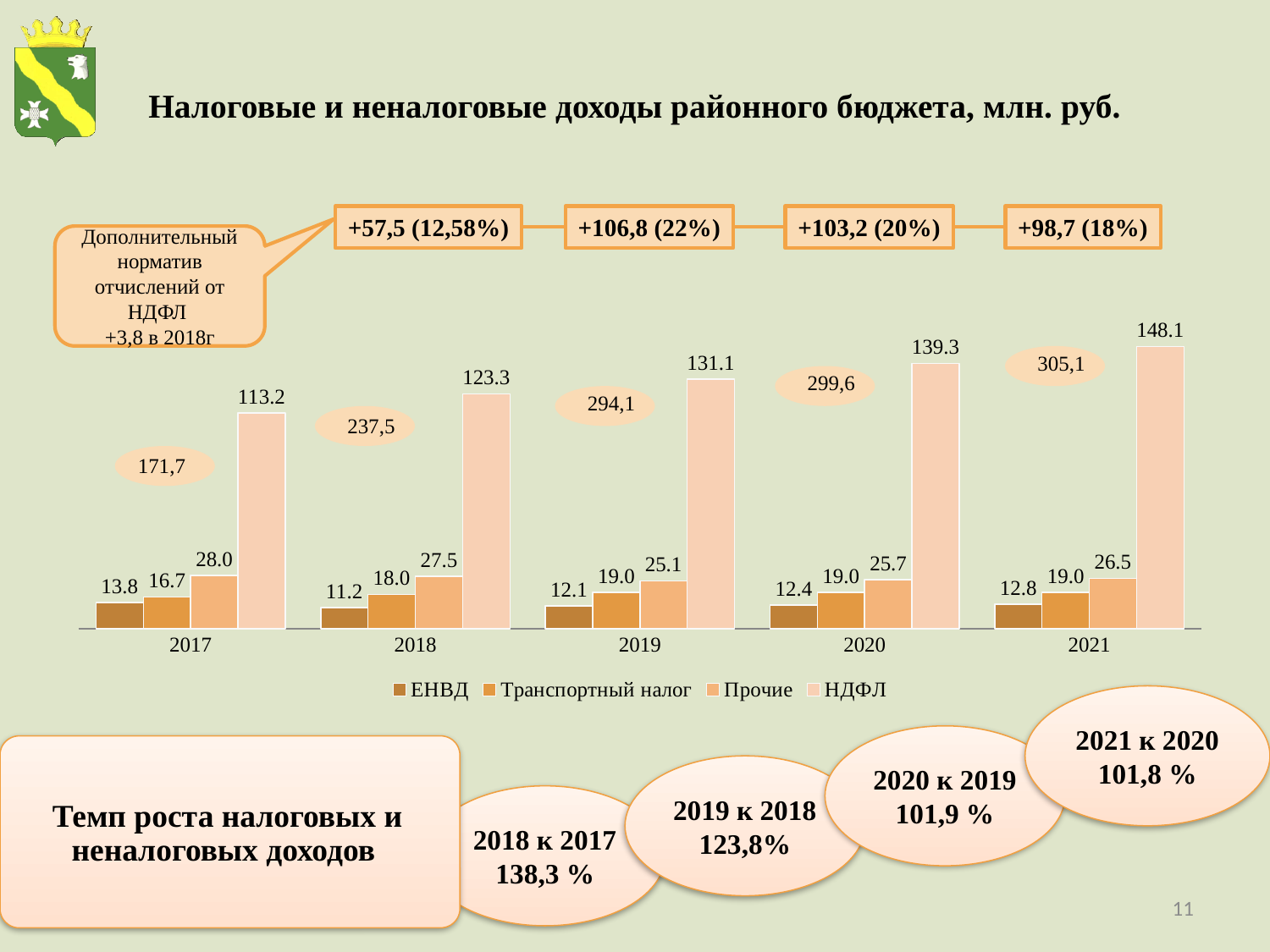
Does the НДФЛ value rise or fall from 2017 to 2021? Rises What is the value of НДФЛ in 2021? 148.1 What is the value of Транспортный налог in 2017? 16.7 How many years are shown on the x axis of the chart? 5 What is the value of Прочие in 2019? 25.1 In which year is the НДФЛ value the highest? 2021 Which is larger: Прочие in 2017 or Прочие in 2018? Прочие in 2017 What kind of chart is shown on the slide? Bar chart In which year is the ЕНВД value the lowest? 2018 How many series does the chart legend list? 4 What is the value of ЕНВД in 2018? 11.2 What is the difference between the НДФЛ values for 2021 and 2020? 8.8